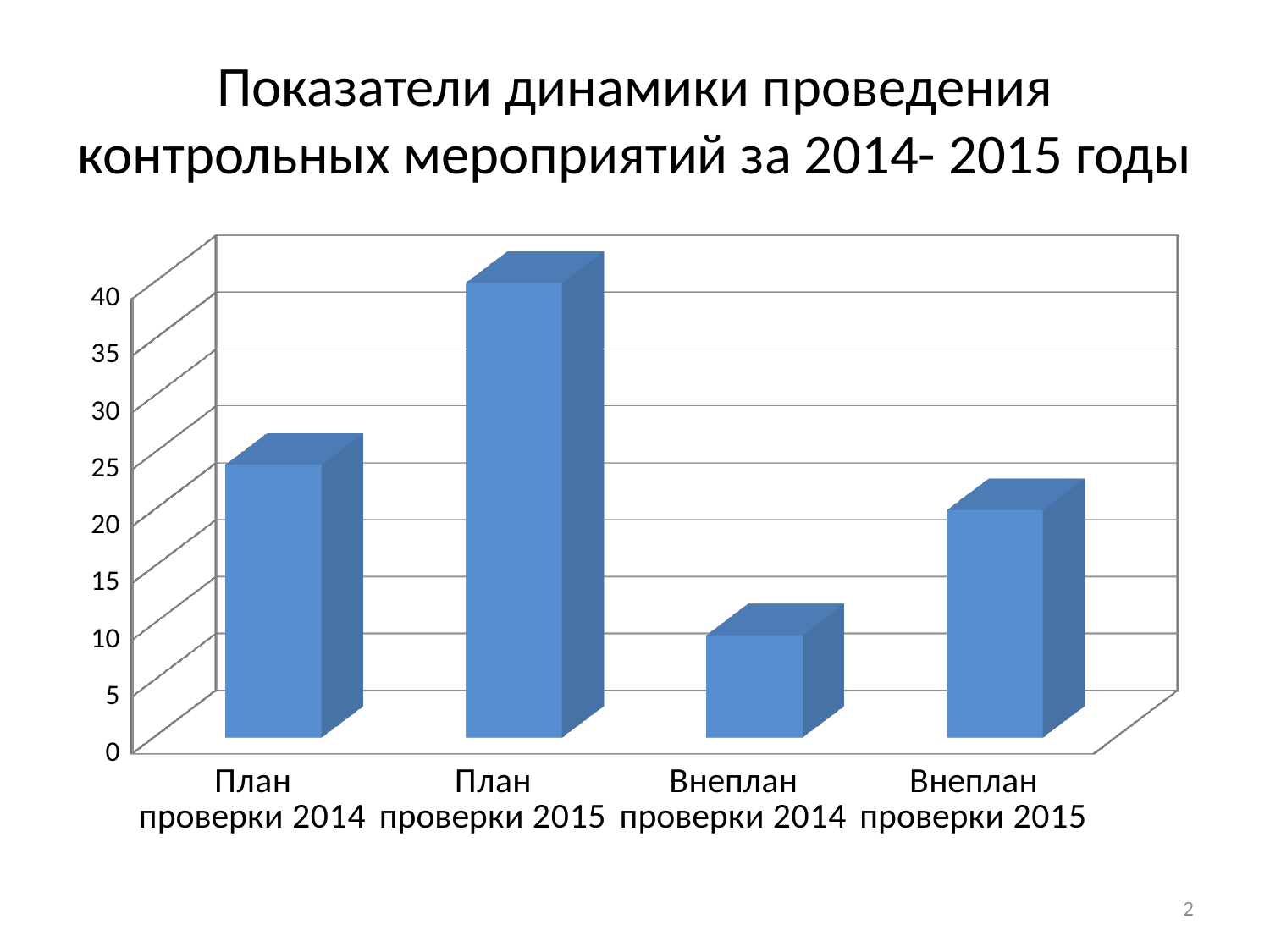
Is the value for Внеплан проверки 2015 greater or less than 25? less Is the value for План проверки 2014 greater or less than 20? greater Does the value rise or fall from План проверки 2014 to План проверки 2015? rise What kind of chart is shown on the slide? bar chart How many categories are shown on the x axis of the chart? 4 Which is larger: the value for План проверки 2014 or the value for Внеплан проверки 2015? План проверки 2014 Which category has the lowest bar in the chart? Внеплан проверки 2014 Which is larger: the value for Внеплан проверки 2015 or the value for Внеплан проверки 2014? Внеплан проверки 2015 What is the title of the slide containing the chart? Показатели динамики проведения контрольных мероприятий за 2014- 2015 годы Which category has the highest bar in the chart? План проверки 2015 Is the value for Внеплан проверки 2014 greater or less than 15? less